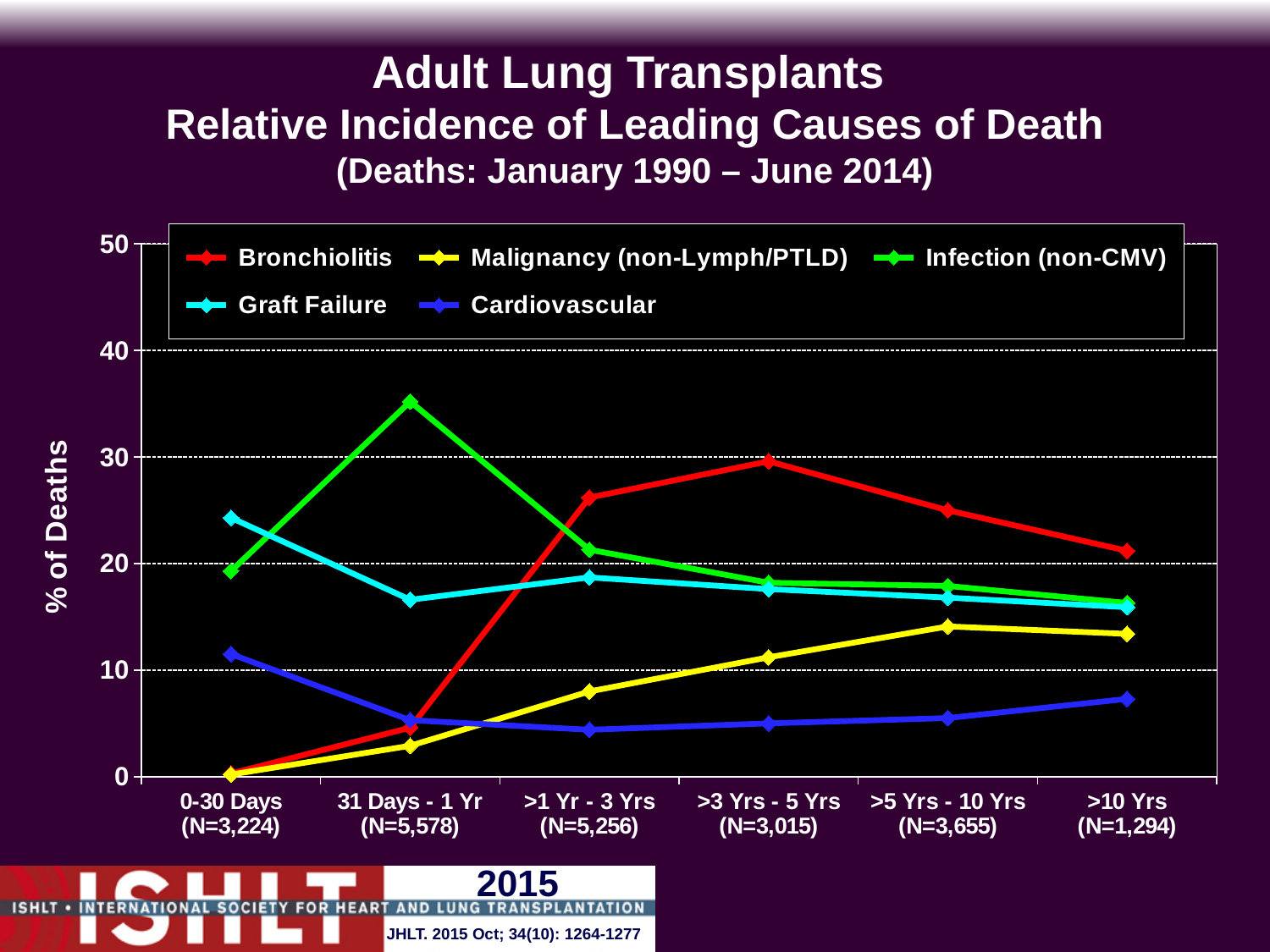
Which cause of death has the lowest % of deaths in the 0-30 Days period? Malignancy (non-Lymph/PTLD) Is the value for Infection (non-CMV) at 31 Days - 1 Yr greater or less than 30? greater Does the Bronchiolitis line rise or fall from >3 Yrs - 5 Yrs to >10 Yrs? fall What kind of chart is shown on the slide? line chart How many series does the legend list? 5 Which cause of death has the highest % of deaths in the 31 Days - 1 Yr period? Infection (non-CMV) What is the N shown for the 31 Days - 1 Yr category? N=5,578 Is the value for Bronchiolitis at 0-30 Days greater or less than 10? less How many time-period categories are shown on the x axis? 6 At 0-30 Days, which is larger: Graft Failure or Infection (non-CMV)? Graft Failure Is the value for Cardiovascular at >10 Yrs greater or less than 10? less Which cause of death has the highest % of deaths in the >3 Yrs - 5 Yrs period? Bronchiolitis